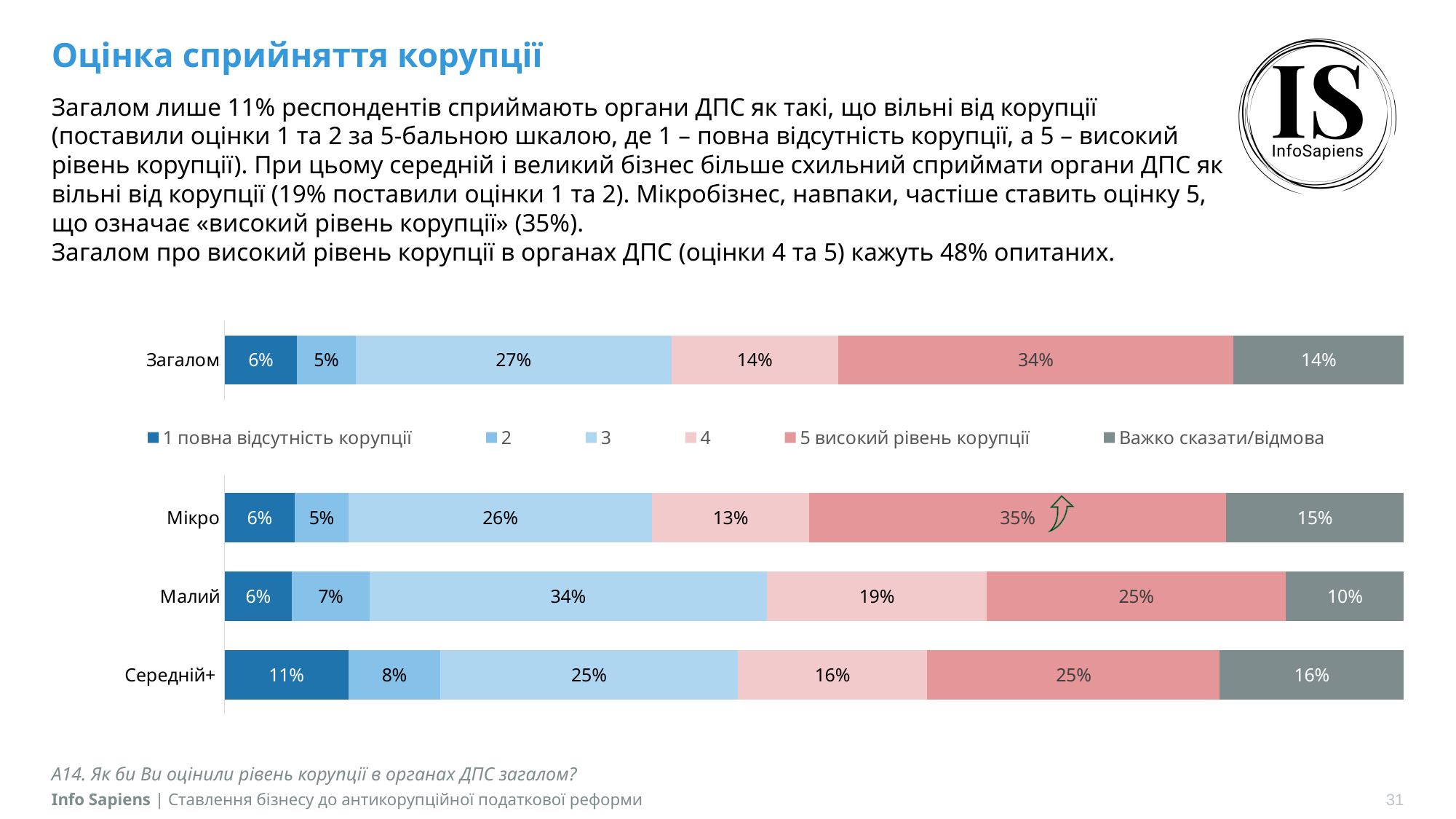
In the bottom chart, what is the difference between the '5 високий рівень корупції' values for 'Мікро' and 'Малий'? 10 percentage points How many categories are shown in the bottom chart? 3 In the bottom chart, which category has the lowest value for 'Важко сказати/відмова'? Малий In the top chart, what is the total of the 'Загалом' stacked bar? 100% In the bottom chart, which category has the highest value for '5 високий рівень корупції'? Мікро How many series does the legend list? 6 In the bottom chart, which has the larger value for series '4': 'Малий' or 'Середній+'? Малий In the bottom chart, what is the value for '1 повна відсутність корупції' for 'Середній+'? 11% In the top chart, what is the value for '5 високий рівень корупції' in the 'Загалом' bar? 34% What kind of chart is used on this slide? Stacked bar chart In the bottom chart, what is the value for series '3' for 'Малий'? 34% In the bottom chart, what is the value for '5 високий рівень корупції' for 'Мікро'? 35%